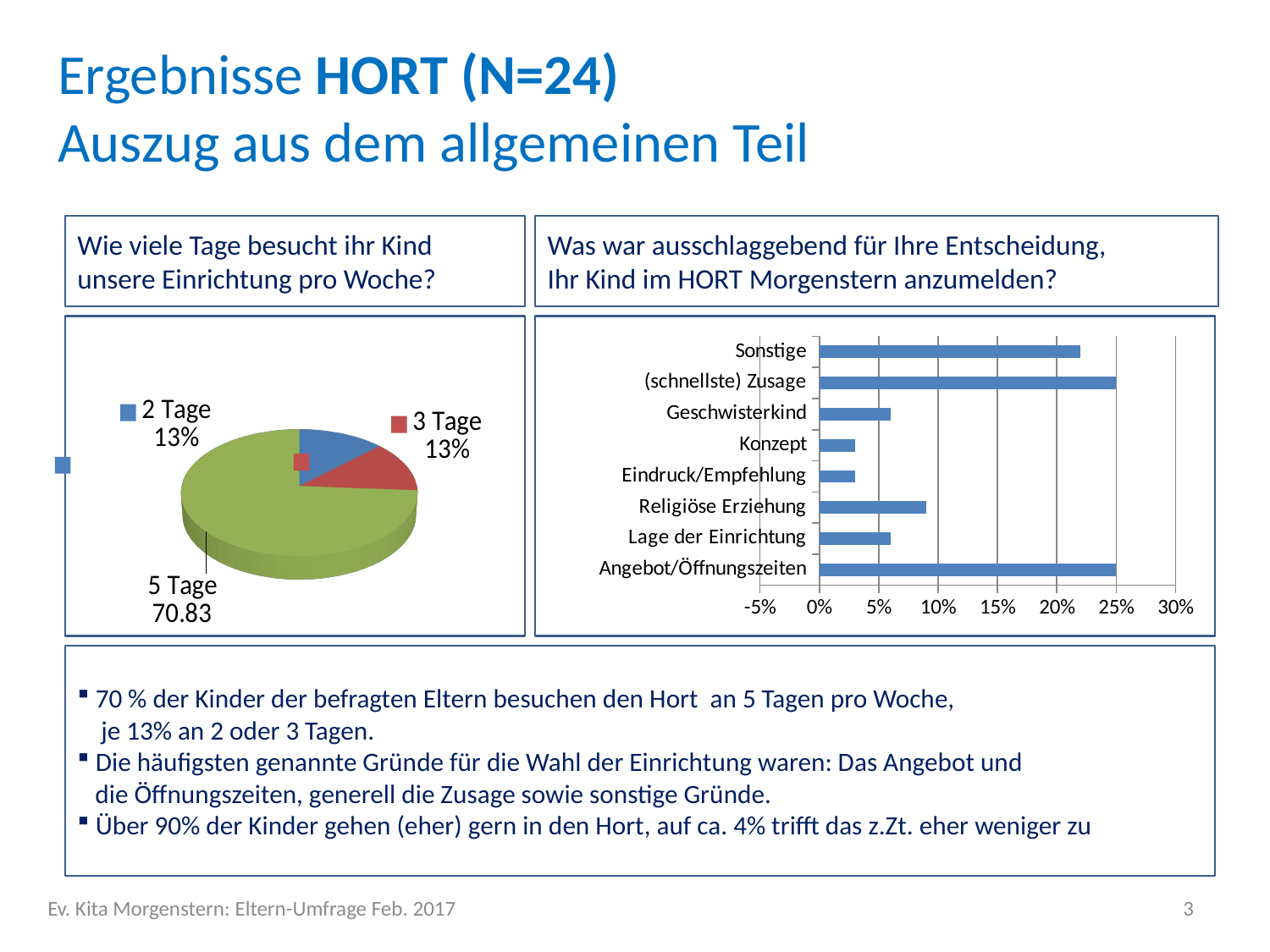
How many categories does the bar chart on the right show? 8 On the bar chart on the right, which is larger: Sonstige or Geschwisterkind? Sonstige On the pie chart on the left, which category has the largest slice? 5 Tage On the bar chart on the right, is the value for Sonstige greater or less than 20%? greater On the bar chart on the right, is the value for Religiöse Erziehung greater or less than 10%? less On the pie chart on the left, what value is shown for 5 Tage? 70.83 On the bar chart on the right, what is the value for Angebot/Öffnungszeiten? 25% What kind of chart is the chart on the right of the slide? bar chart What kind of chart is the chart on the left of the slide? pie chart On the pie chart on the left, what share of children attend 2 Tage per week? 13% On the bar chart on the right, what is the value for (schnellste) Zusage? 25% How many slices does the pie chart on the left have? 3